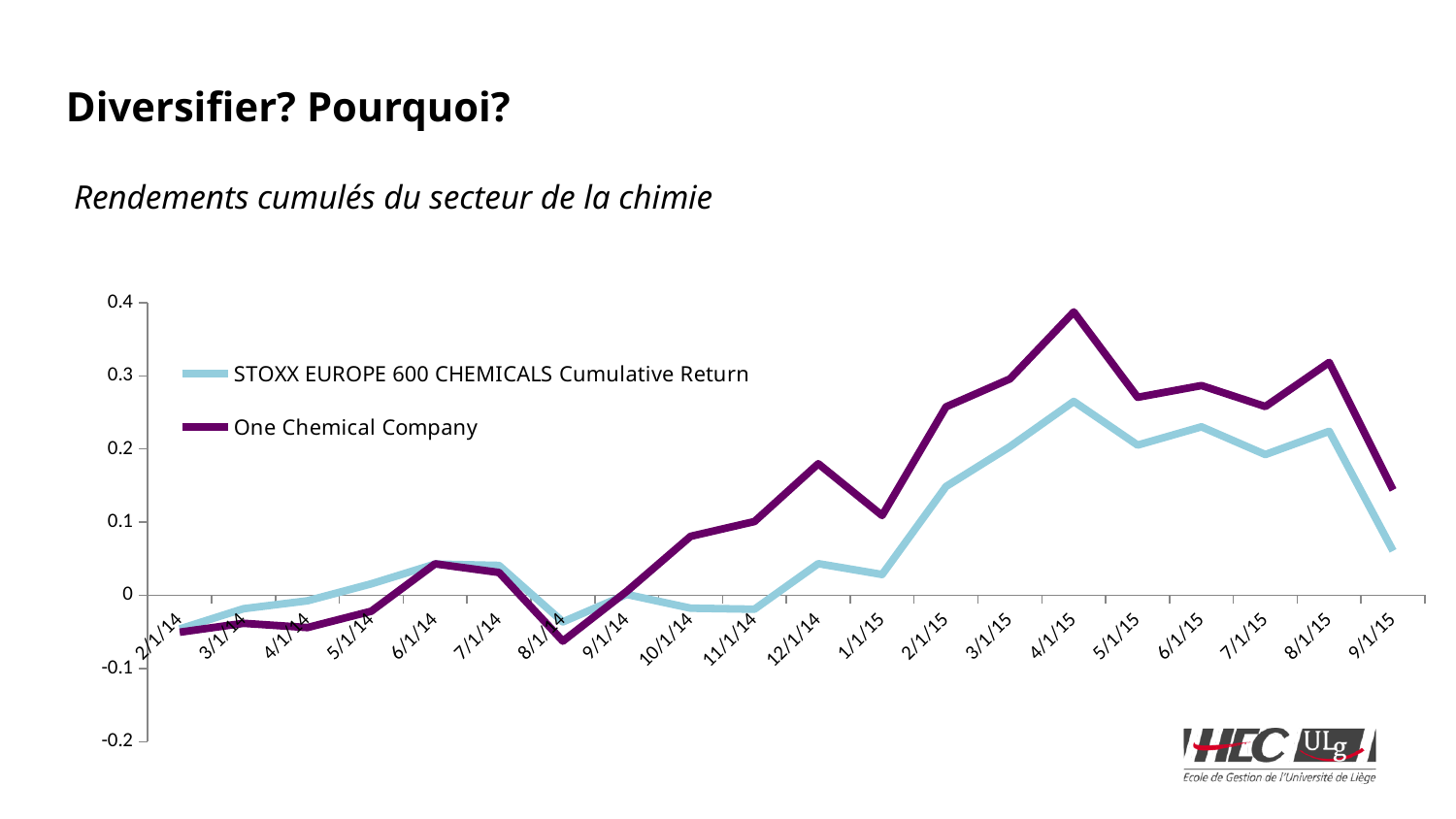
Which series is drawn in dark purple? One Chemical Company How many dates are labelled along the x axis? 20 Do the values of the STOXX EUROPE 600 CHEMICALS Cumulative Return series rise or fall between 1/1/15 and 4/1/15? rise Is the value for One Chemical Company at 8/1/14 greater or less than 0? less Is the value for STOXX EUROPE 600 CHEMICALS Cumulative Return at 9/1/15 greater or less than 0.1? less What is the subtitle written above the chart? Rendements cumulés du secteur de la chimie What kind of chart is shown on the slide? line chart At 12/1/14, which series has the higher value: STOXX EUROPE 600 CHEMICALS Cumulative Return or One Chemical Company? One Chemical Company Is the value for One Chemical Company at 4/1/15 greater or less than 0.3? greater At which date does the One Chemical Company series reach its highest value? 4/1/15 How many series does the legend list? 2 At which date does the One Chemical Company series reach its lowest value? 8/1/14